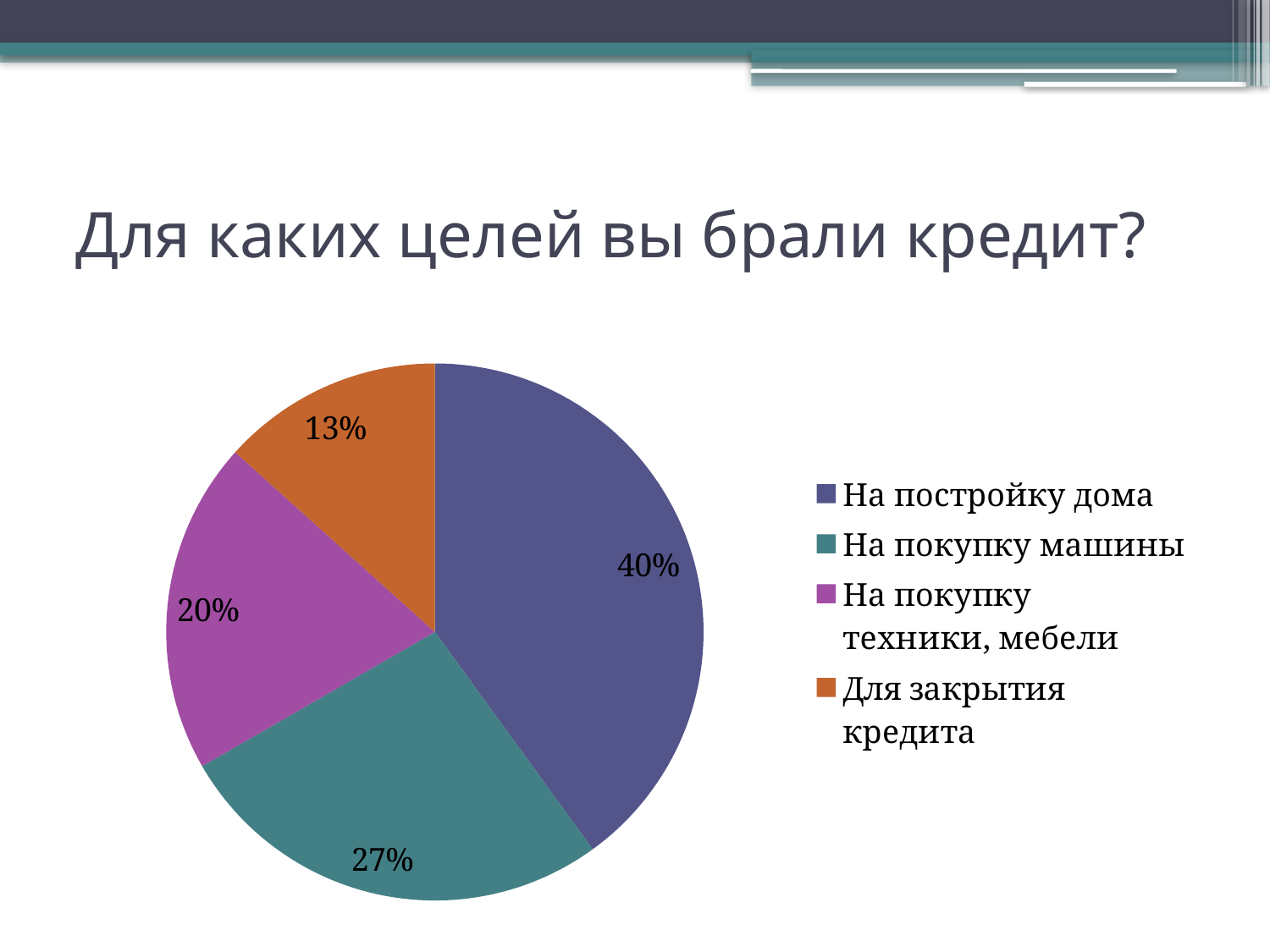
What share of the pie is labelled for "На покупку машины"? 27% Which category has the largest slice of the pie? На постройку дома How many slices does the pie chart have? 4 What share of the pie is labelled for "Для закрытия кредита"? 13% What type of chart is shown on the slide? pie chart What share of the pie is labelled for "На покупку техники, мебели"? 20% What is the title of the slide containing the chart? Для каких целей вы брали кредит? How many entries does the legend list? 4 Which category has the smallest slice of the pie? Для закрытия кредита What is the difference in percentage points between "На постройку дома" and "На покупку машины"? 13 Which is larger: the slice for "На покупку техники, мебели" or the slice for "Для закрытия кредита"? На покупку техники, мебели What share of the pie is labelled for "На постройку дома"? 40%